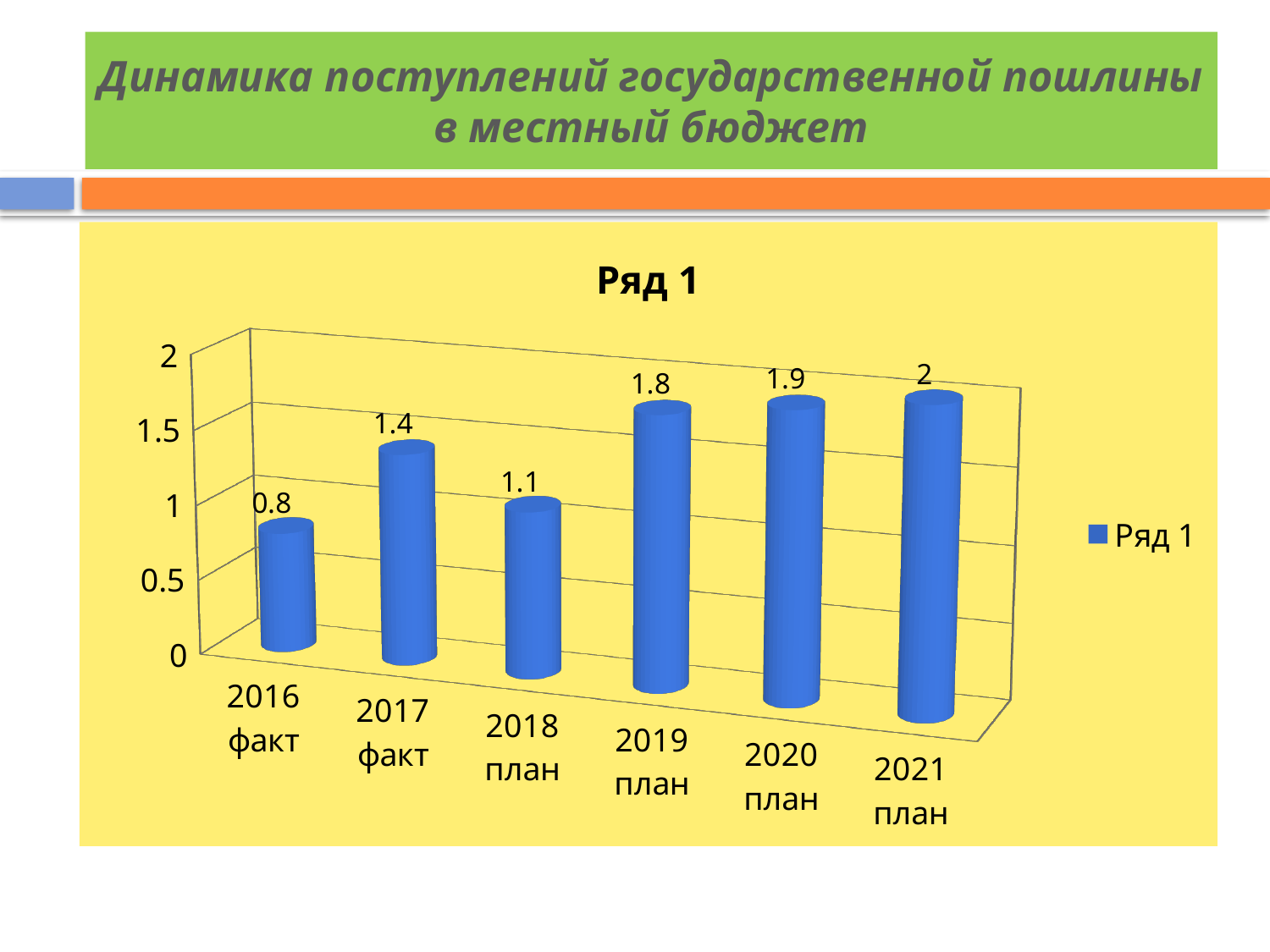
What kind of chart is shown on the slide? bar chart What is the value for 2019 план? 1.8 Which category has the lowest value? 2016 факт What is the difference between the values for 2017 факт and 2018 план? 0.3 What is the difference between the values for 2021 план and 2016 факт? 1.2 What is the value for 2016 факт? 0.8 Which category has the highest value? 2021 план What is the value for 2018 план? 1.1 Which is larger, the value for 2017 факт or the value for 2018 план? 2017 факт How many categories are shown on the x axis? 6 How many series does the legend list? 1 What is the title of the chart? Ряд 1